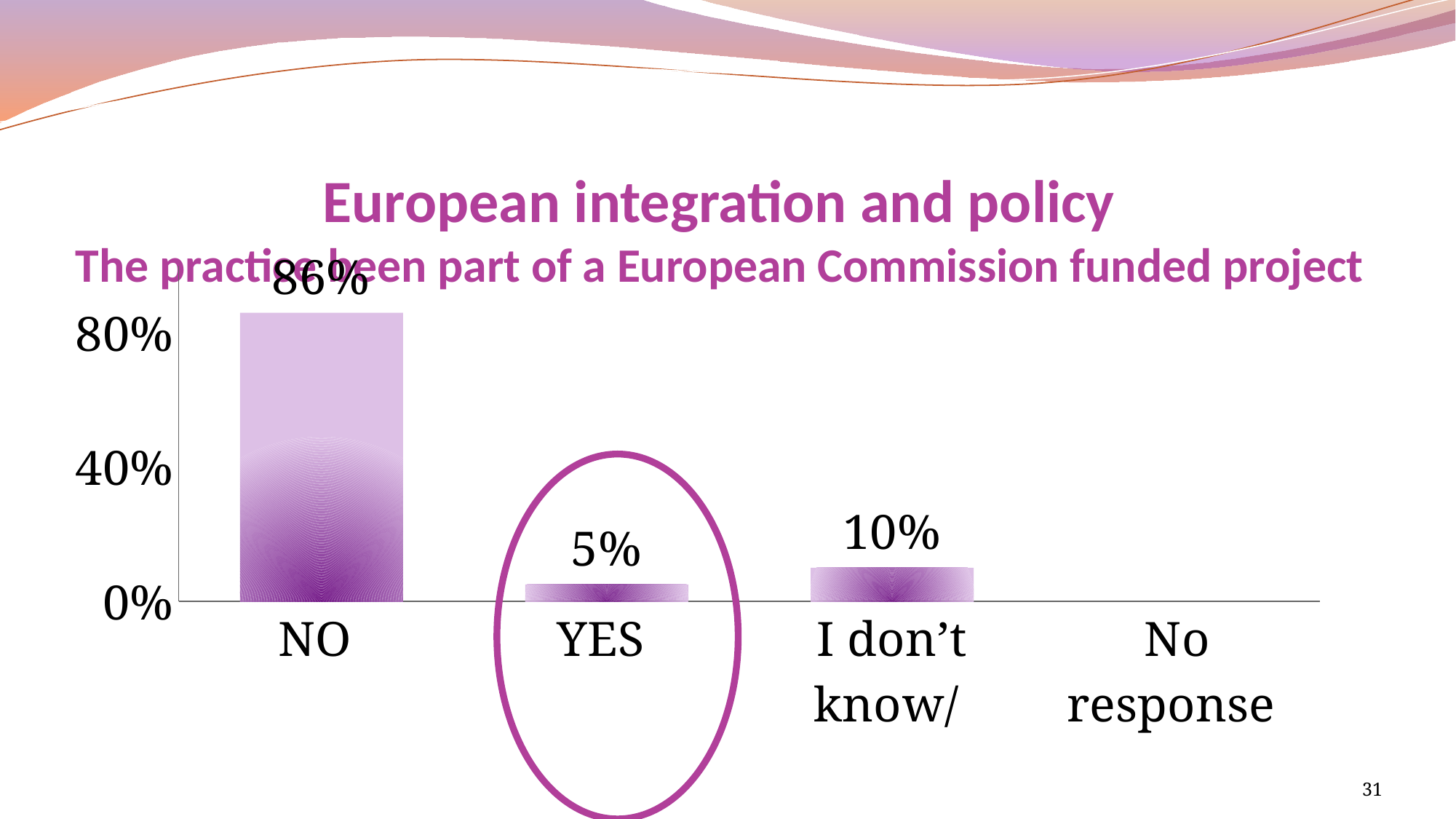
What is the value for I don't know/? 10% What is the value for NO? 86% How many categories are shown on the x axis? 4 Which category is circled on the chart? YES Which is larger, the value for YES or the value for I don't know/? I don't know/ What is the value for YES? 5% What is the title of the chart? The practice been part of a European Commission funded project What kind of chart is shown on the slide? bar chart What is the difference between the values for I don't know/ and YES? 5% What is the difference between the values for NO and YES? 81% Which category has the highest value? NO Is the value for NO greater or less than 40%? greater